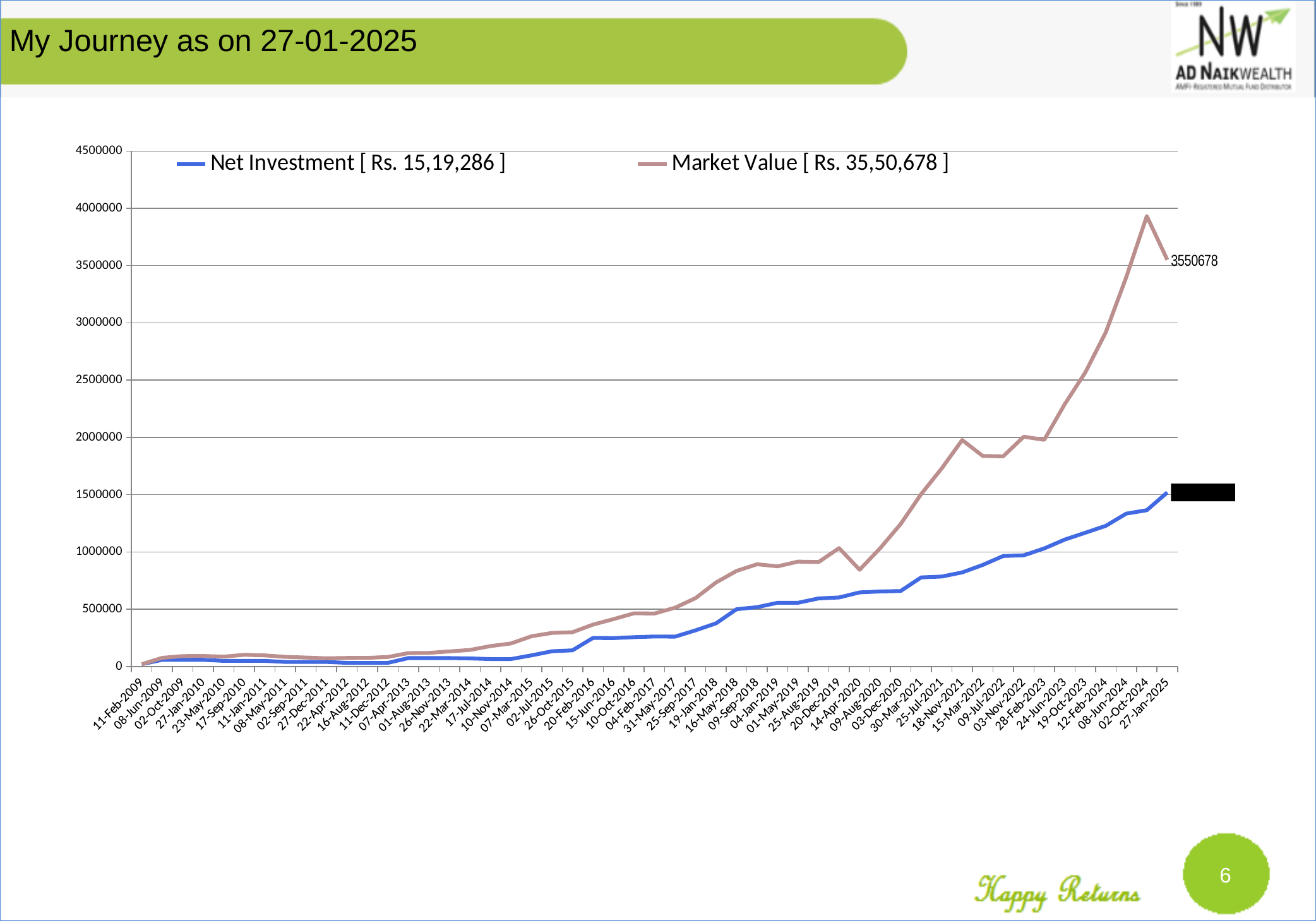
What Market Value amount is shown in the legend? Rs. 35,50,678 What kind of chart is shown on the slide? line chart Does the Net Investment line rise or fall from 11-Feb-2009 to 27-Jan-2025? rises Which is larger at 27-Jan-2025, Market Value or Net Investment? Market Value What is the difference between the Market Value and the Net Investment shown in the legend? Rs. 20,31,392 What colour is the Net Investment line? blue What is the Market Value at 27-Jan-2025 according to the data label on the chart? 3550678 What Net Investment amount is shown in the legend? Rs. 15,19,286 Is the Market Value at 18-Nov-2021 greater or less than 1500000? greater Is the Market Value at 02-Oct-2024 greater or less than 3500000? greater Is the Market Value at 14-Apr-2020 greater or less than 1000000? less How many series does the chart's legend list? 2